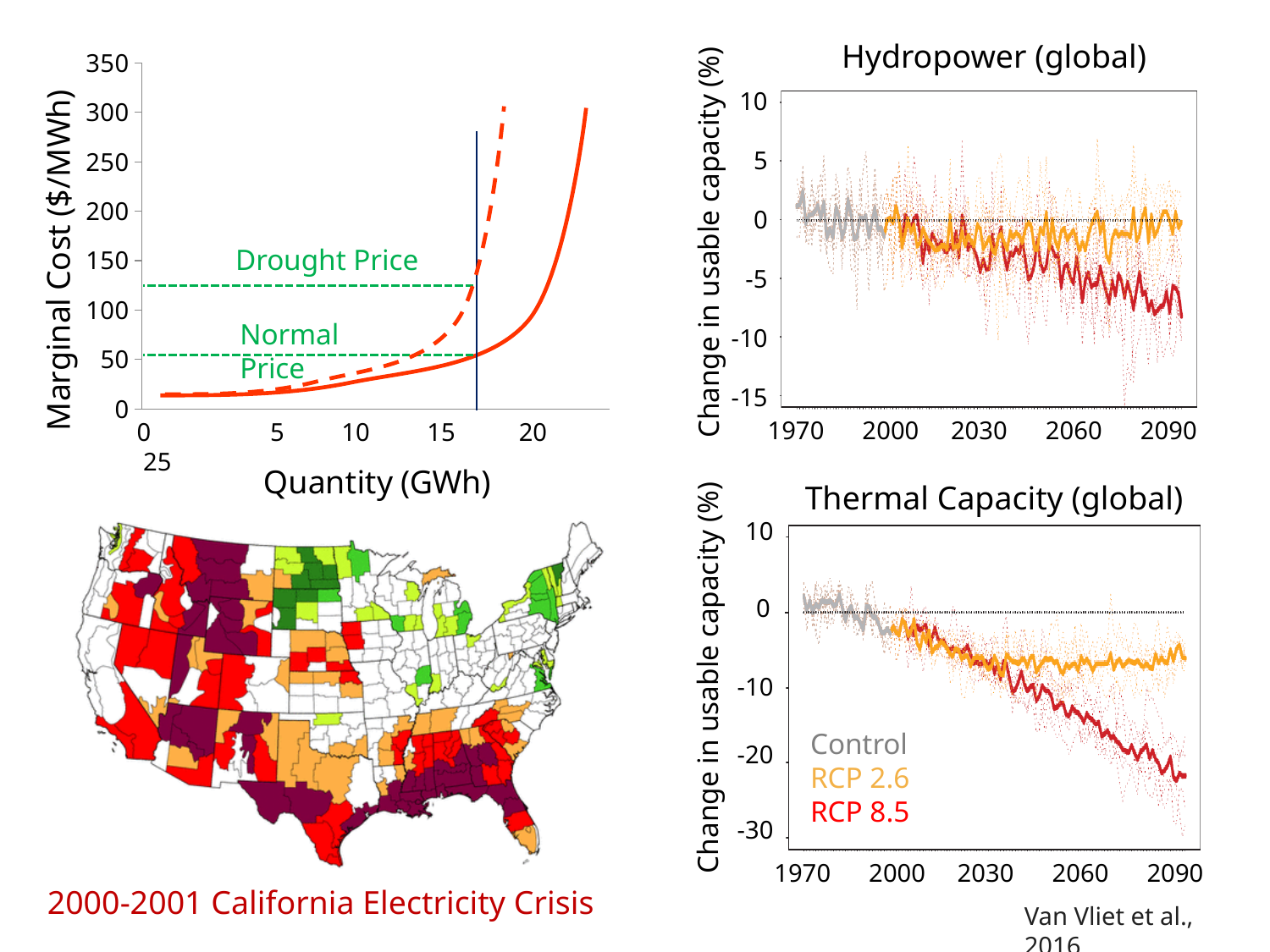
In the Hydropower (global) chart, is the RCP 8.5 value around 2090 greater or less than -5%? less In the top-left chart, is the Normal Price greater or less than 100 $/MWh? less In the top-left chart, which is higher, the Drought Price or the Normal Price? Drought Price What is the x-axis label of the top-left chart? Quantity (GWh) In the Hydropower (global) chart, which series is higher around 2090, RCP 2.6 or RCP 8.5? RCP 2.6 In the top-left chart, is the Drought Price greater or less than 100 $/MWh? greater In the Thermal Capacity (global) chart, which series is higher around 2090, RCP 2.6 or RCP 8.5? RCP 2.6 In the Thermal Capacity (global) chart, does the RCP 8.5 series rise or fall from 2000 to 2090? fall How many series does the legend list for the Thermal Capacity (global) chart? 3 What kind of chart is the top-left chart showing Marginal Cost against Quantity? line chart What is the title of the bottom-right chart? Thermal Capacity (global)